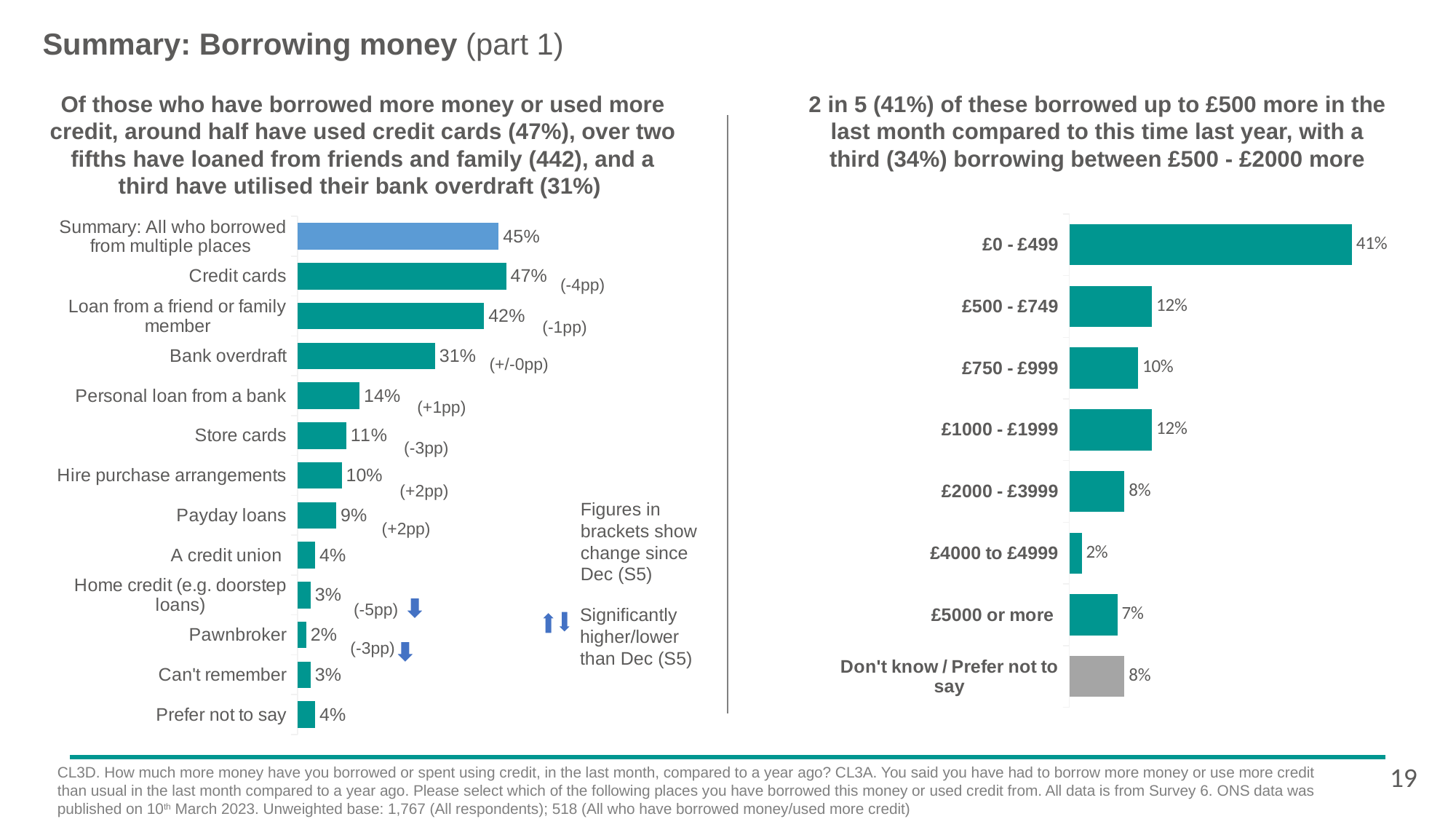
In the left chart, what is the value for Bank overdraft? 31% In the right chart, what is the difference between £0 - £499 and £500 - £749? 29 percentage points In the left chart, which category has the lowest value? Pawnbroker In the right chart, what percentage borrowed £0 - £499 more? 41% In the right chart, which amount band has the lowest value? £4000 to £4999 In the left chart, what change since Dec (S5) is shown in brackets for Credit cards? (-4pp) In the left chart, what is the difference between Credit cards and Loan from a friend or family member? 5 percentage points In the right chart, how many categories are shown? 8 In the left chart, which borrowing source has the highest value? Credit cards In the left chart, which is larger: Personal loan from a bank or Store cards? Personal loan from a bank What type of chart is the right chart? Bar chart In the left chart, what percentage of those who borrowed more used credit cards? 47%